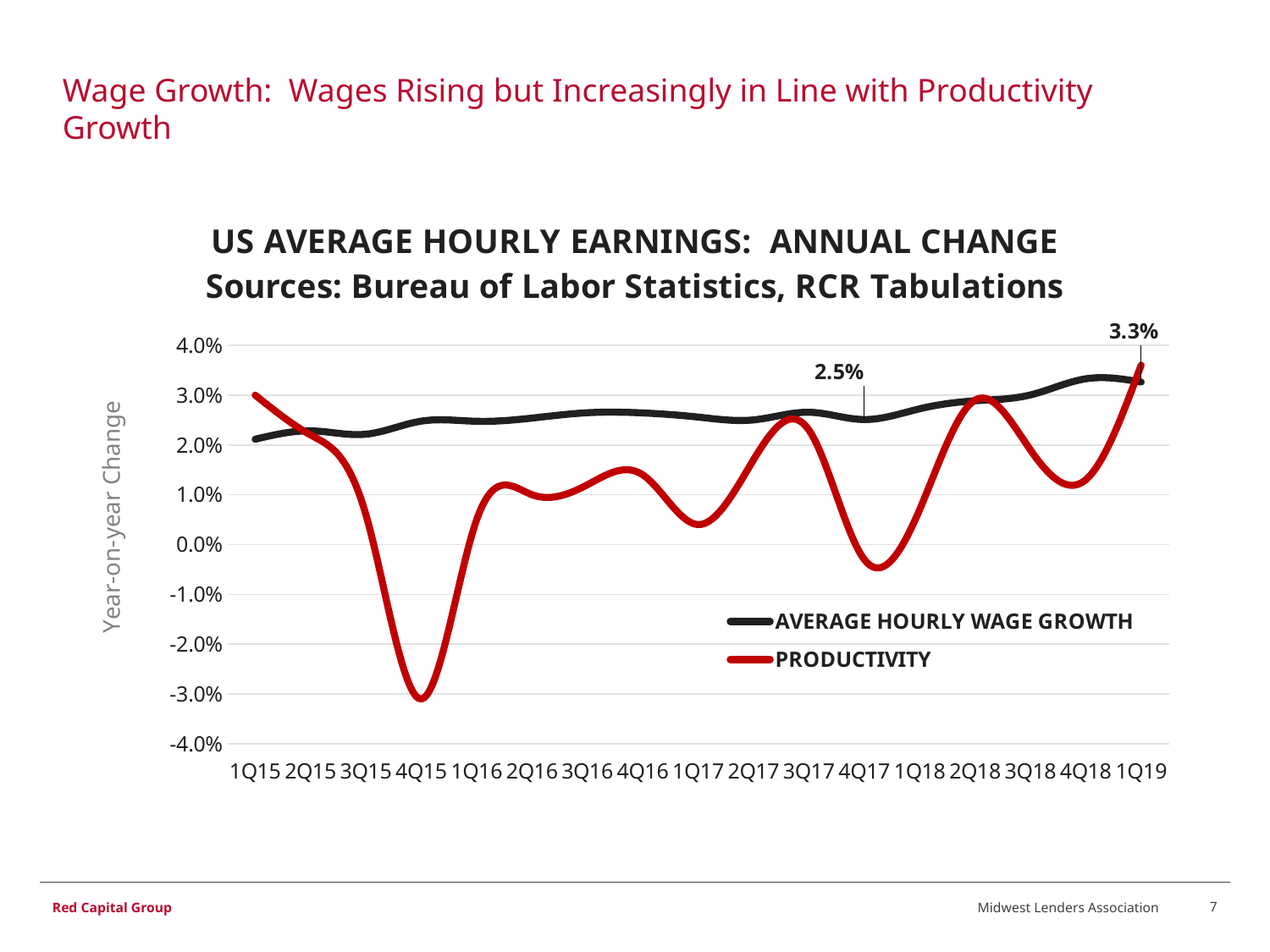
How many quarters are shown along the x axis? 17 How many series does the legend list? 2 What value is labeled for Average Hourly Wage Growth at 4Q17? 2.5% What colour is the Productivity line? Red Is the Average Hourly Wage Growth value at 1Q15 greater or less than 1.0%? greater Does Average Hourly Wage Growth generally rise or fall from 1Q15 to 1Q19? Rise Is the Productivity value at 4Q17 greater or less than 0.0%? less Is the Productivity value at 4Q15 greater or less than -2.0%? less At 4Q15, which series has the higher value, Average Hourly Wage Growth or Productivity? Average Hourly Wage Growth In which quarter does Productivity reach its lowest value? 4Q15 What is the data label shown at 1Q19? 3.3% What kind of chart is shown on the slide? Line chart